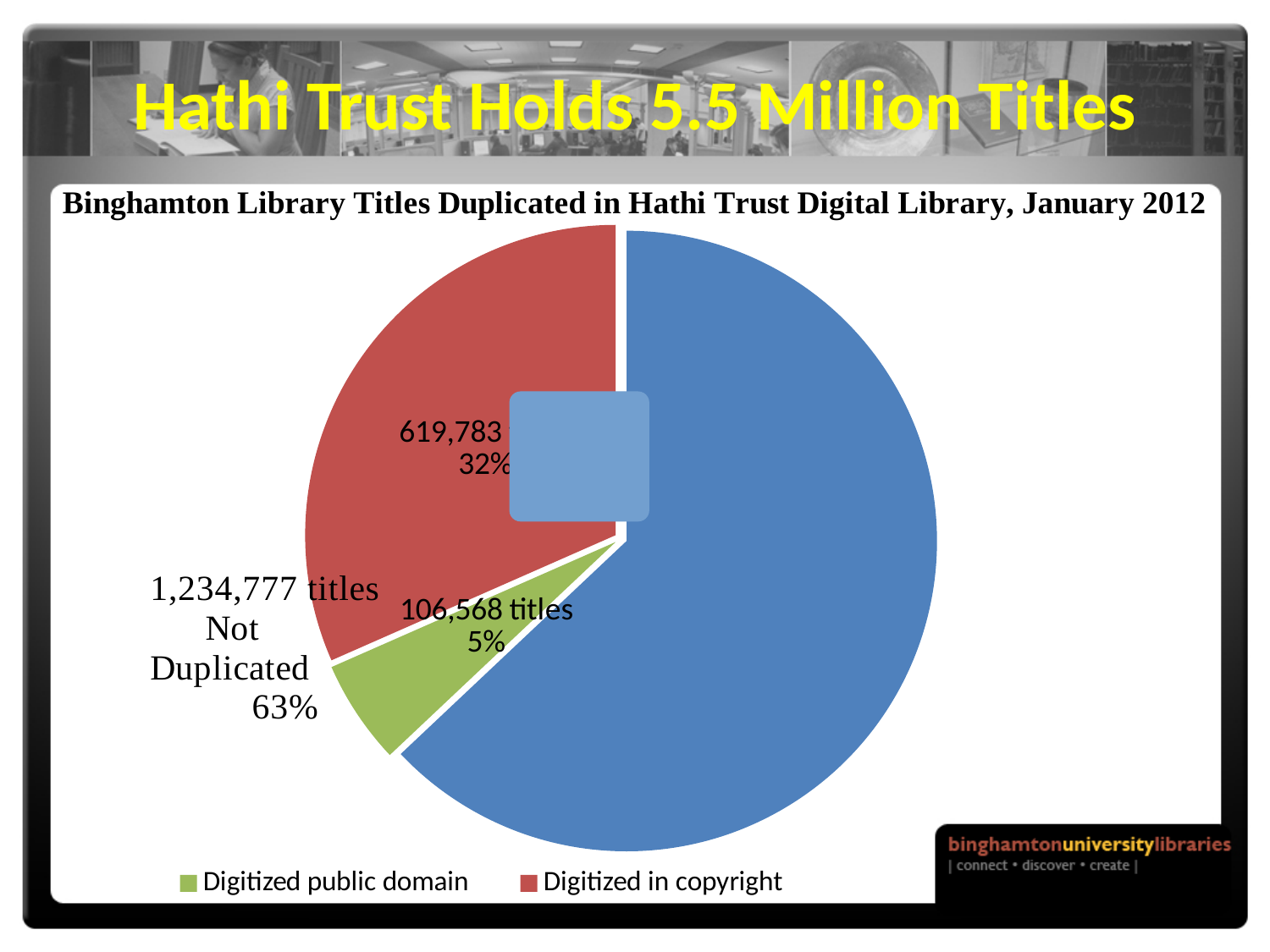
Which slice of the pie is the largest? Not Duplicated What is the title of the chart? Binghamton Library Titles Duplicated in Hathi Trust Digital Library, January 2012 What percentage of titles are Not Duplicated? 63% What percentage of the pie is Digitized public domain? 5% How many slices does the pie chart have? 3 Which slice of the pie is the smallest? Digitized public domain How many titles are Not Duplicated? 1,234,777 titles What type of chart is shown on the slide? Pie chart What percentage of the pie is Digitized in copyright? 32% How many entries does the chart legend list? 2 How many titles are Digitized public domain? 106,568 titles How many titles are Digitized in copyright? 619,783